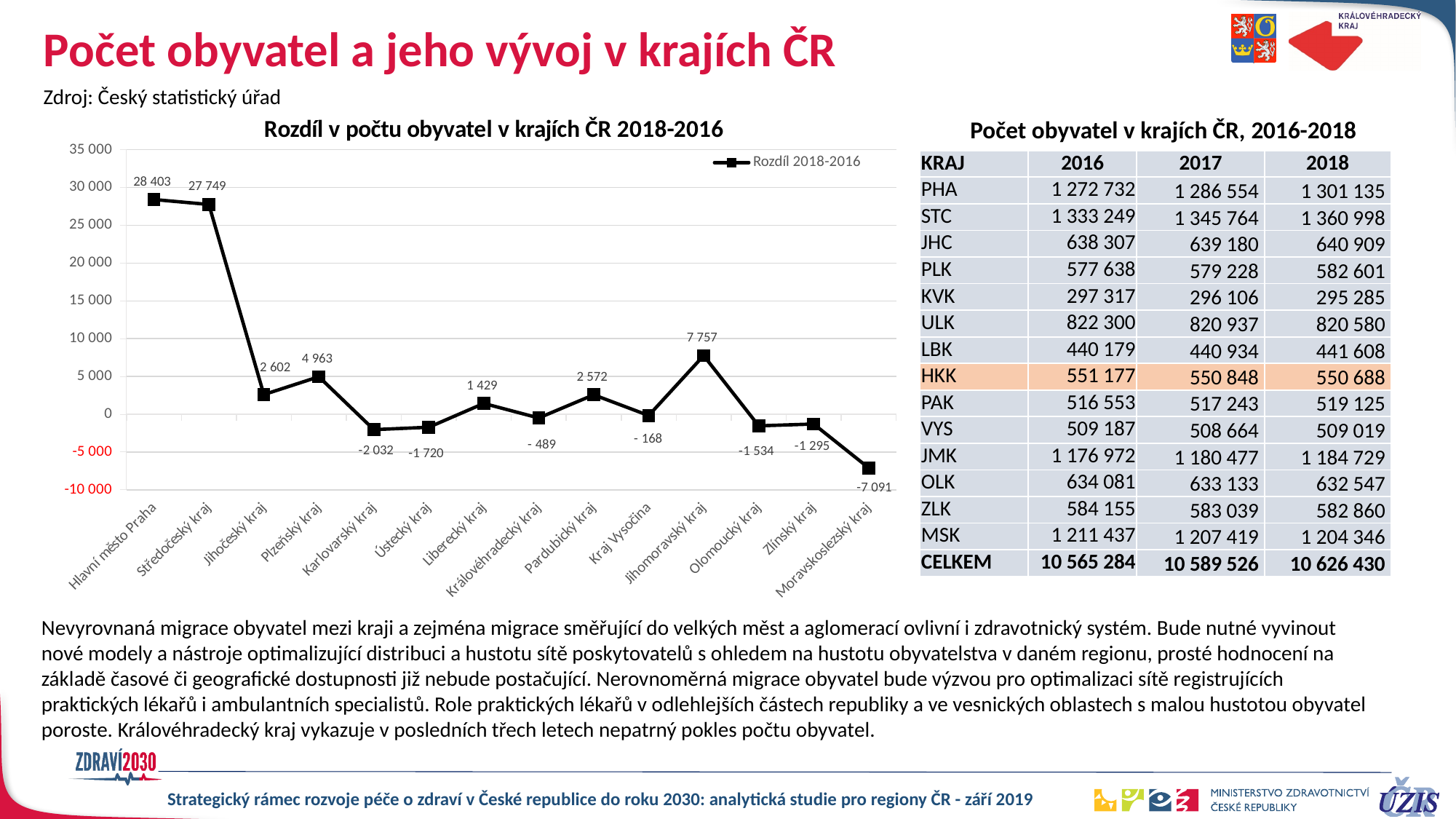
Which has the larger value, Plzeňský kraj or Jihočeský kraj? Plzeňský kraj What is the name of the series listed in the chart legend? Rozdíl 2018-2016 What is the value for Moravskoslezský kraj in the chart? -7 091 What is the value for Královéhradecký kraj in the chart? - 489 Which region has the lowest value in the chart? Moravskoslezský kraj What is the value for Hlavní město Praha in the chart? 28 403 Is the value for Jihomoravský kraj greater or less than 5 000? greater How many regions are plotted on the x axis of the chart? 14 What is the difference between the values for Hlavní město Praha and Středočeský kraj? 654 Which region has the highest value in the chart? Hlavní město Praha What is the value for Jihomoravský kraj in the chart? 7 757 What kind of chart is shown on the slide? line chart